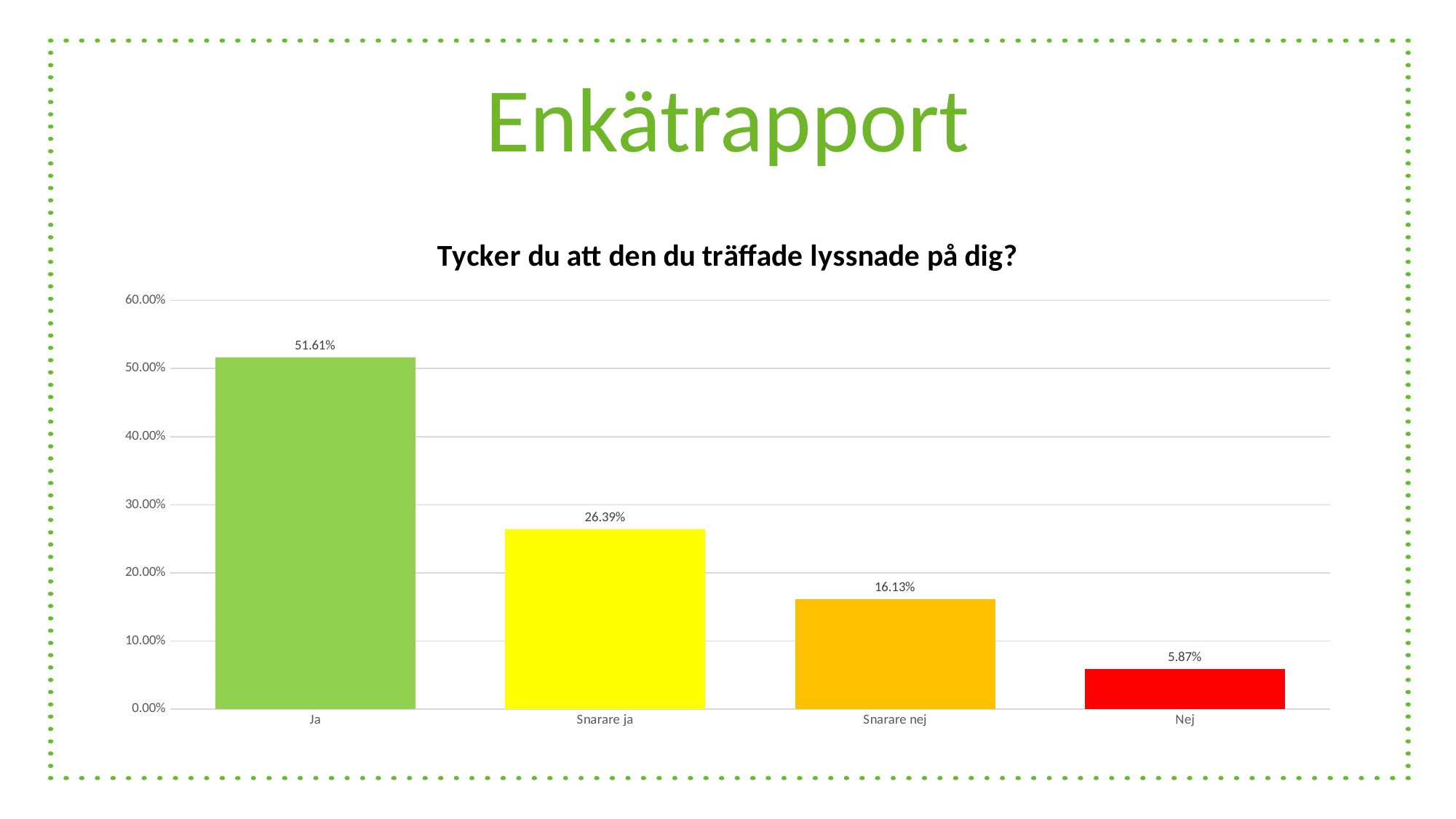
Which category has the highest value? Ja What is the value for "Nej"? 5.87% Which category has the lowest value? Nej What kind of chart is shown on the slide? bar chart What is the value for "Snarare nej"? 16.13% Which is larger, the value for "Snarare nej" or the value for "Nej"? Snarare nej Is the value for "Snarare ja" greater or less than 30.00%? less How many categories are shown on the x axis? 4 What is the title of the chart? Tycker du att den du träffade lyssnade på dig? What is the value for "Ja"? 51.61% What is the value for "Snarare ja"? 26.39% What is the difference between the values for "Ja" and "Snarare ja"? 25.22%